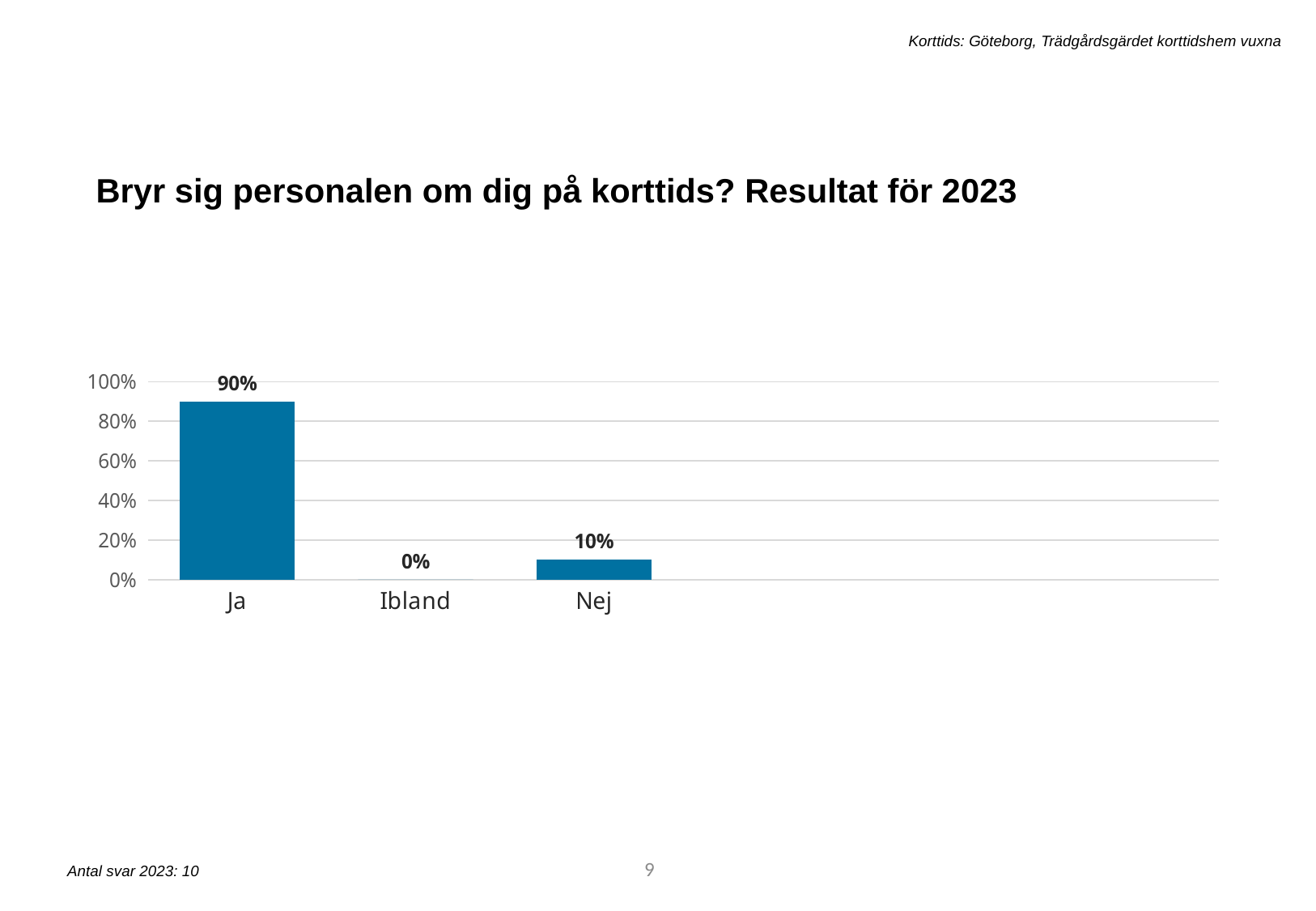
What is the highest value shown on the y axis? 100% What is the difference between the values for Ja and Nej? 80% How many categories are shown on the x axis? 3 What is the value for Nej? 10% Is the value for Ja greater or less than 80%? greater What is the value for Ibland? 0% Which is larger, the value for Nej or the value for Ibland? Nej Which category has the highest value? Ja What is the title of the chart? Bryr sig personalen om dig på korttids? Resultat för 2023 What is the value for Ja? 90% What kind of chart is shown on the slide? bar chart Which category has the lowest value? Ibland